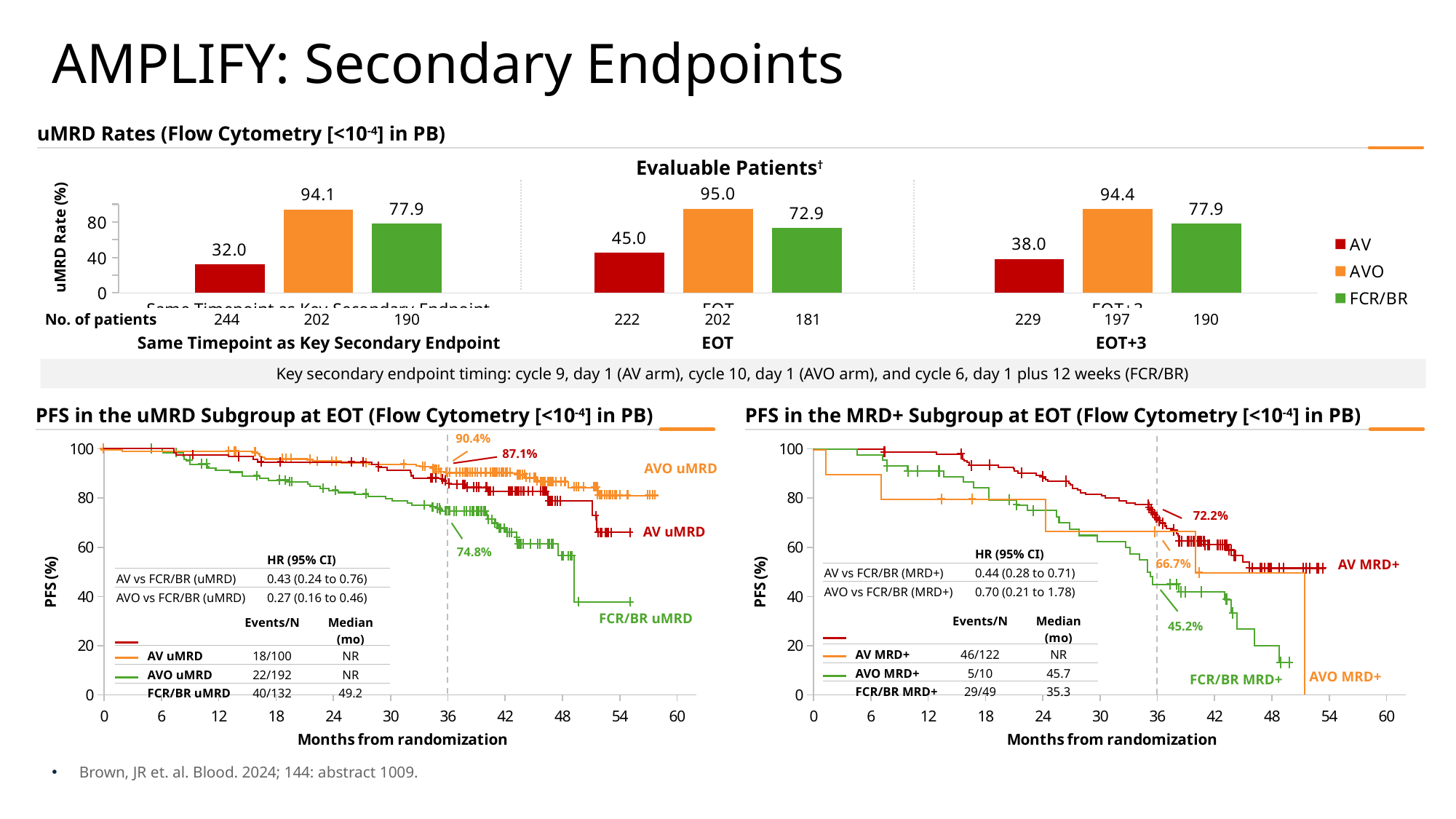
In the uMRD Rates bar chart, what is the uMRD rate for AV at the Same Timepoint as Key Secondary Endpoint? 32.0 What kind of chart is the uMRD Rates chart at the top of the slide? bar chart In the PFS in the uMRD Subgroup at EOT chart, what is the labelled PFS value for FCR/BR uMRD at 36 months? 74.8% In the PFS in the MRD+ Subgroup at EOT chart, what is the labelled PFS value for AV MRD+ at 36 months? 72.2% In the uMRD Rates bar chart, which arm has the lowest uMRD rate at EOT? AV In the uMRD Rates bar chart, which arm has the highest uMRD rate at EOT+3? AVO In the uMRD Rates bar chart, what is the uMRD rate for FCR/BR at EOT+3? 77.9 In the PFS in the MRD+ Subgroup at EOT chart, which curve is shown in green? FCR/BR MRD+ In the uMRD Rates bar chart, what is the uMRD rate for AVO at EOT? 95.0 How many series does the legend of the uMRD Rates bar chart list? 3 In the uMRD Rates bar chart, what is the difference between the AVO and AV uMRD rates at EOT? 50.0 In the uMRD Rates bar chart, is the uMRD rate for AV at EOT+3 greater or less than 40? less